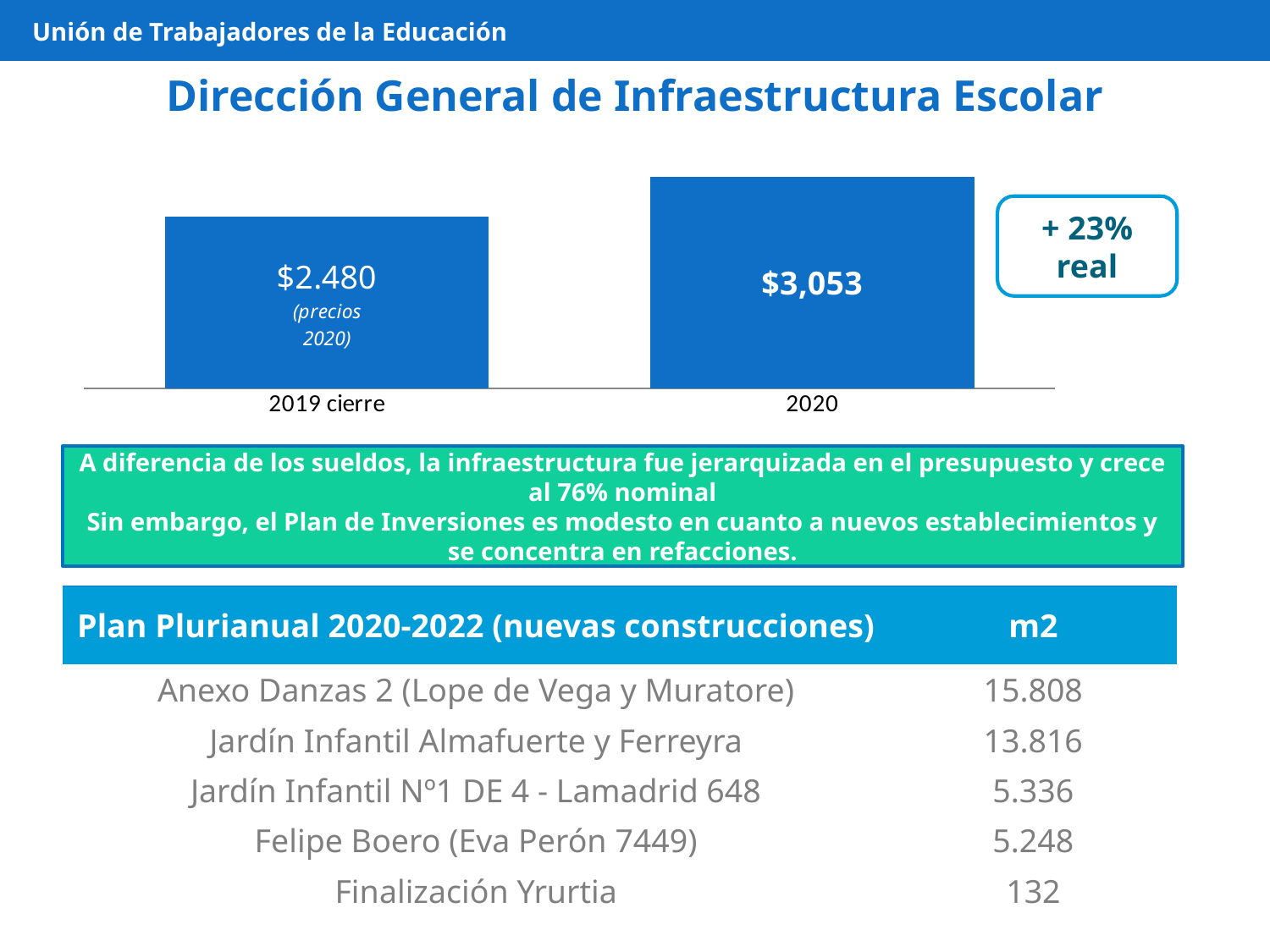
How many bars are plotted in the chart? 2 What is the value shown for the 2020 bar? $3,053 What real percentage change is shown in the callout next to the chart? + 23% real Which is larger, the value for 2019 cierre or the value for 2020? 2020 What is the difference between the 2020 value and the 2019 cierre value? $573 Which category has the lowest bar? 2019 cierre What note in parentheses appears under the 2019 cierre value? (precios 2020) What is the value shown for the 2019 cierre bar? $2.480 What kind of chart is shown on the slide? bar chart Do the values rise or fall from 2019 cierre to 2020? rise Which category has the highest bar? 2020